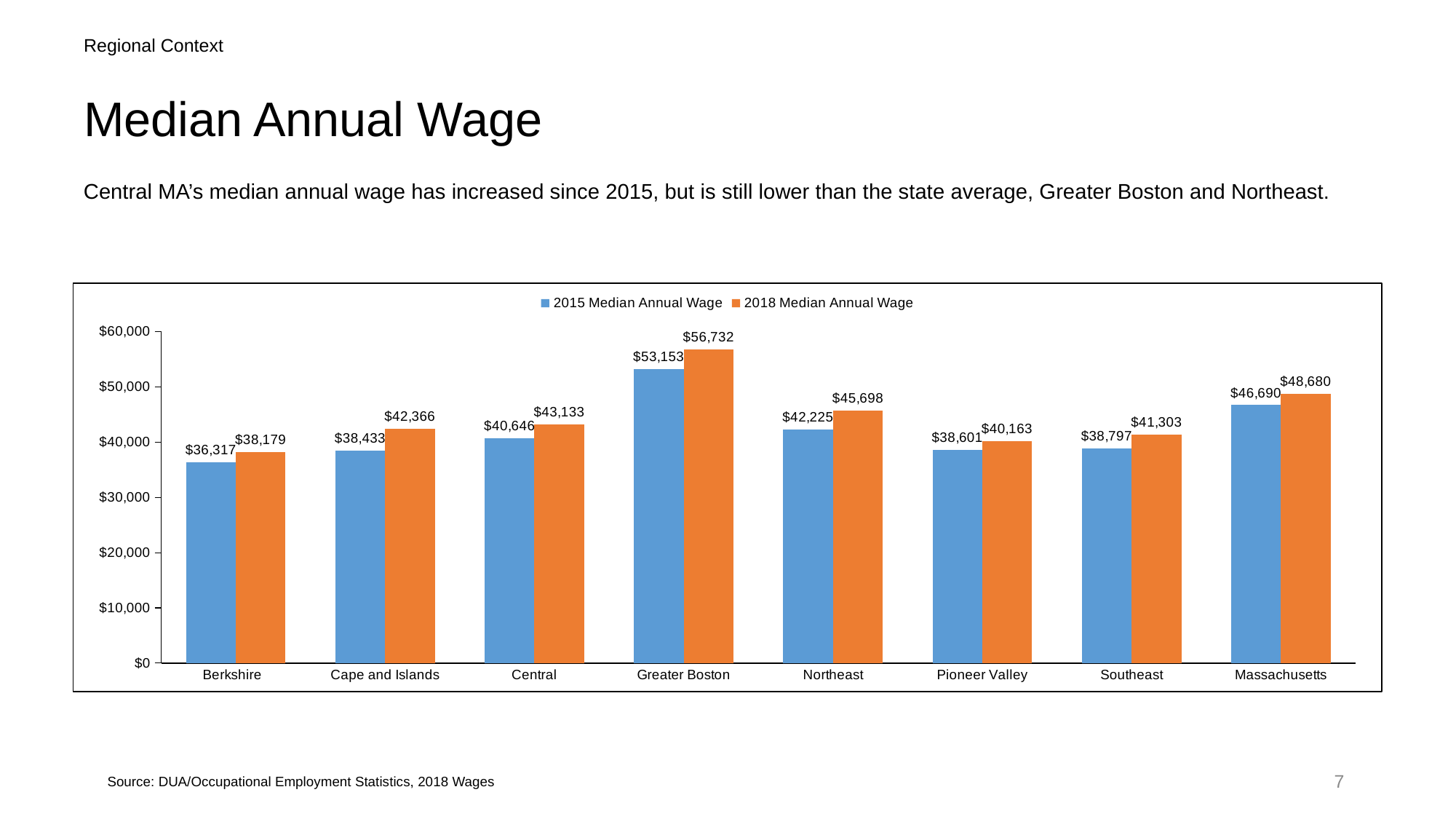
Is the 2015 Median Annual Wage for Pioneer Valley greater or less than $40,000? less How many series does the legend list? 2 Which region has the highest 2018 Median Annual Wage? Greater Boston What is the 2018 Median Annual Wage for Massachusetts? $48,680 What is the 2018 Median Annual Wage for Central? $43,133 What kind of chart is shown on the slide? Bar chart Which colour represents the 2018 Median Annual Wage series? Orange What is the difference between the 2018 and 2015 Median Annual Wage for Northeast? $3,473 How many regions are shown on the x axis of the chart? 8 Which region has the lowest 2015 Median Annual Wage? Berkshire What is the 2015 Median Annual Wage for Greater Boston? $53,153 Which is larger, the 2018 Median Annual Wage for Cape and Islands or for Southeast? Cape and Islands